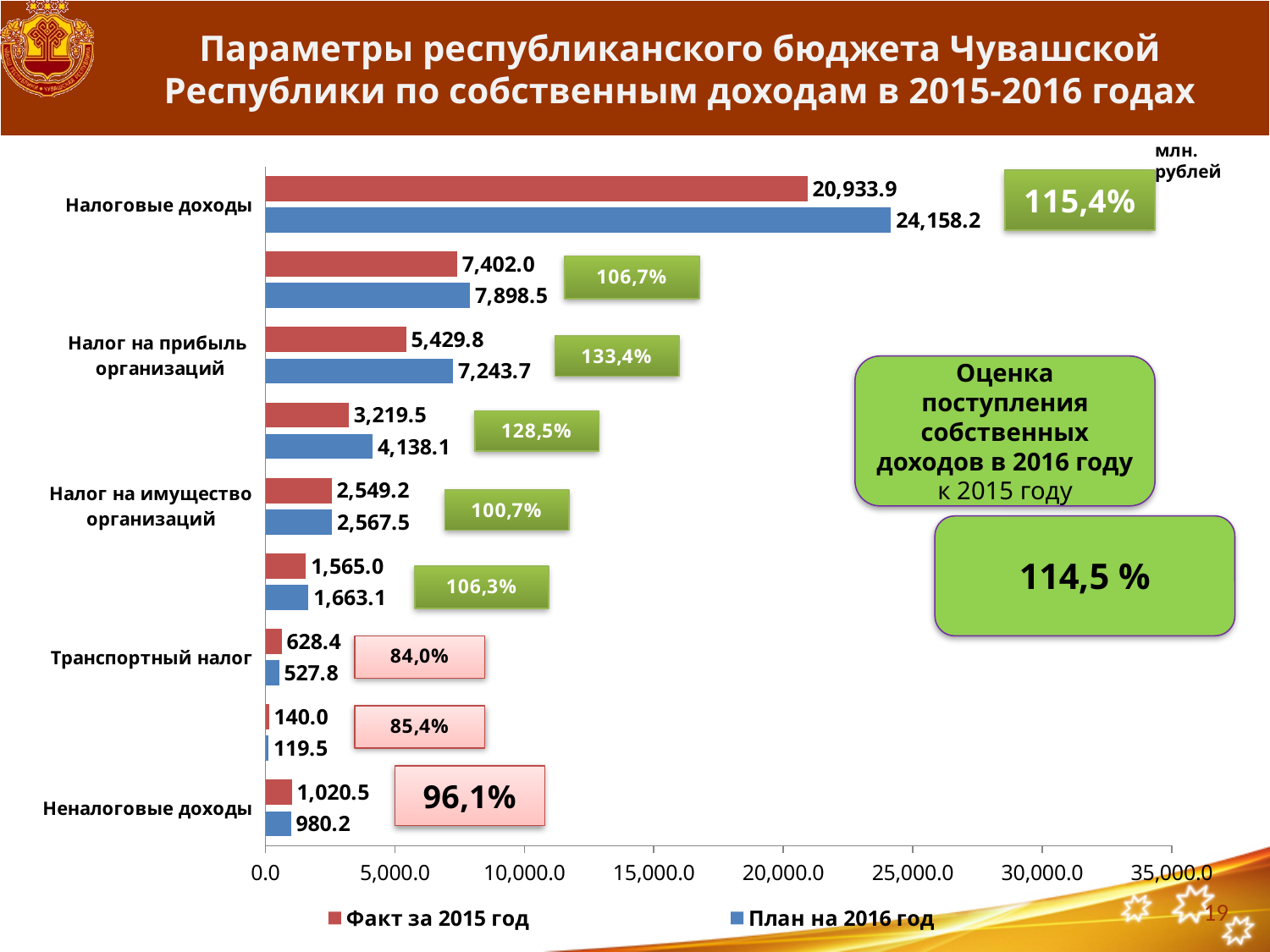
What is the value of Факт за 2015 год for Транспортный налог? 628.4 How many series does the legend list? 2 Is the value of План на 2016 год for Налог на прибыль организаций greater or less than 5,000.0? greater What kind of chart is shown on the slide? bar chart What is the value of План на 2016 год for Неналоговые доходы? 980.2 By how much does План на 2016 год exceed Факт за 2015 год for Налоговые доходы? 3,224.3 What is the value of План на 2016 год for Налог на прибыль организаций? 7,243.7 For Транспортный налог, which is larger: Факт за 2015 год or План на 2016 год? Факт за 2015 год What is the difference between План на 2016 год and Факт за 2015 год for Налог на имущество организаций? 18.3 Which category has the highest value for План на 2016 год? Налоговые доходы What is the value of Факт за 2015 год for Налоговые доходы? 20,933.9 What is the value of План на 2016 год for Налоговые доходы? 24,158.2